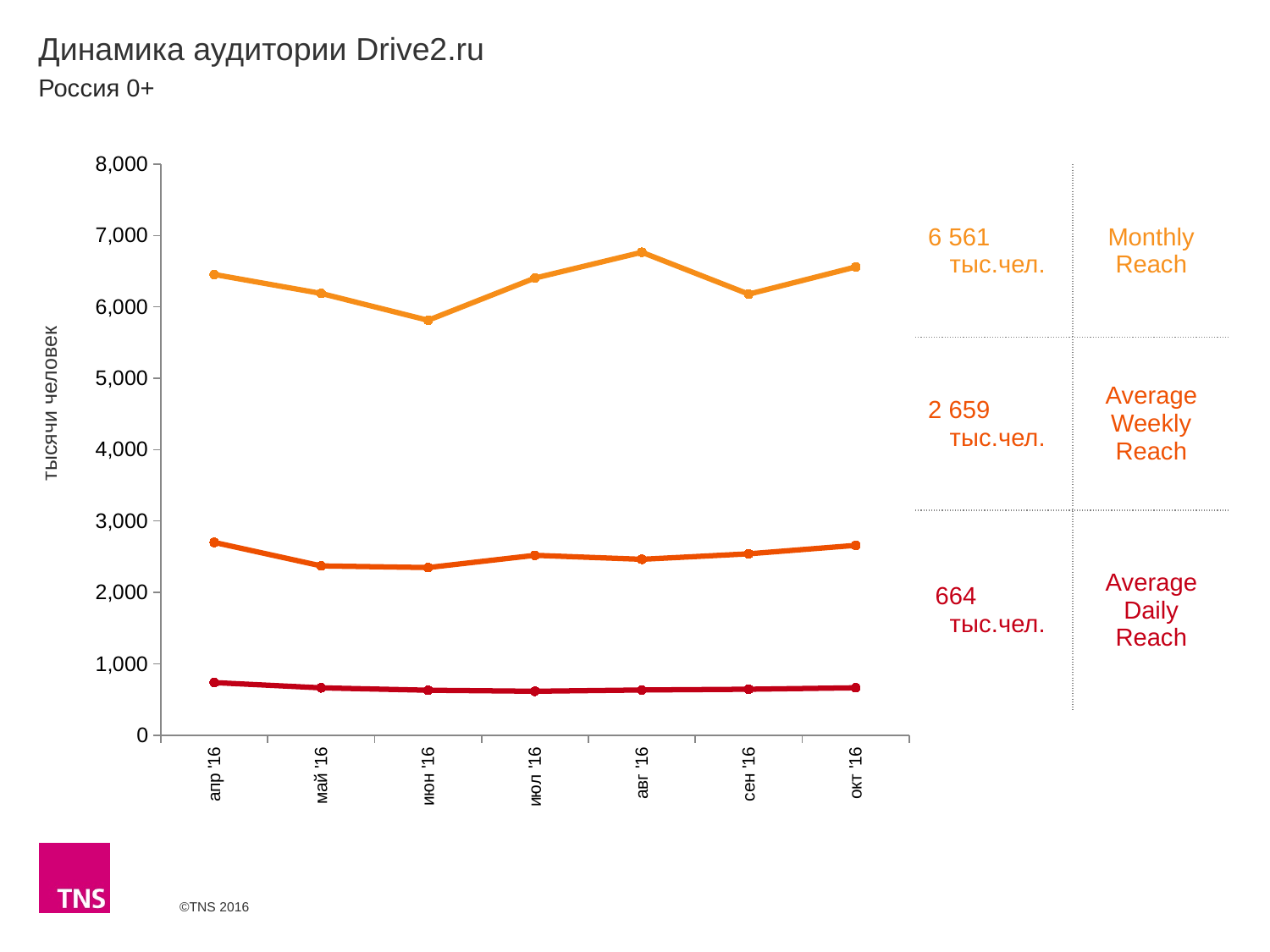
What is the Average Daily Reach value shown for окт '16? 664 тыс.чел. How many months are plotted along the x axis? 7 What kind of chart is shown on the slide? line chart Which month has the higher Monthly Reach, апр '16 or сен '16? апр '16 In which month is the Monthly Reach line at its lowest? июн '16 What is the difference between the Monthly Reach and the Average Weekly Reach values shown for окт '16? 3 902 тыс.чел. How many lines (series) are plotted on the chart? 3 Is the Average Weekly Reach value for апр '16 greater or less than 2,000? greater What is the Monthly Reach value shown for окт '16? 6 561 тыс.чел. What is the Average Weekly Reach value shown for окт '16? 2 659 тыс.чел. In which month is the Monthly Reach line at its highest? авг '16 Is the Monthly Reach value for июн '16 greater or less than 6,000? less